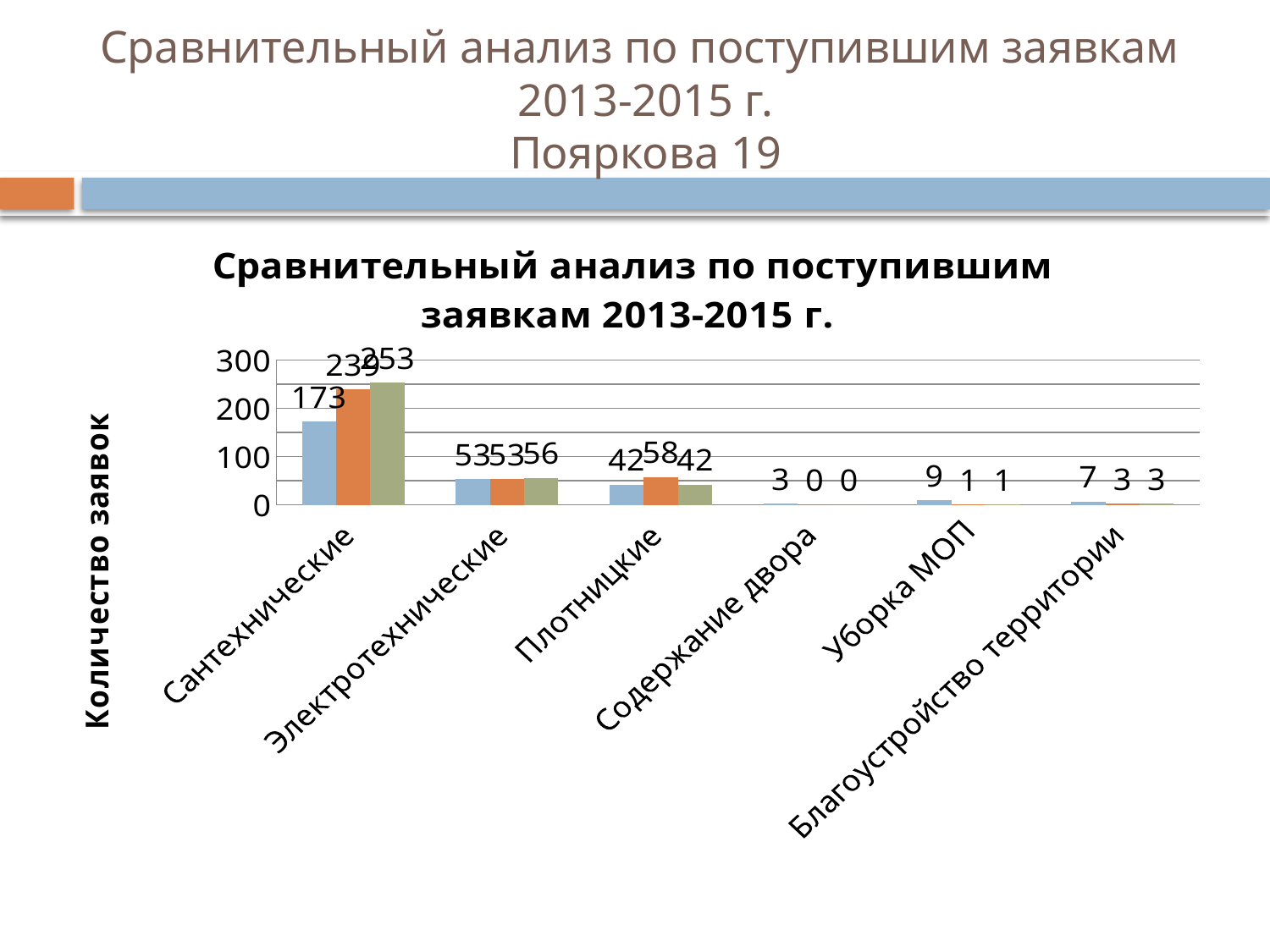
Which category has the tallest bar in the chart? Сантехнические Is the value of the blue bar for Сантехнические greater or less than 100? greater What is the title of the vertical axis of the chart? Количество заявок What is the value of the middle (orange) bar for Плотницкие? 58 What is the difference between the green bar (253) and the blue bar (173) for Сантехнические? 80 What is the value of the third (green) bar for Сантехнические? 253 Which is larger: the blue bar for Электротехнические or the blue bar for Плотницкие? Электротехнические What is the value of the first (blue) bar for Сантехнические? 173 How many categories are shown on the x axis of the chart? 6 What kind of chart is shown on the slide? bar chart What is the difference between the orange bar (58) and the blue bar (42) for Плотницкие? 16 What is the value of the first (blue) bar for Уборка МОП? 9